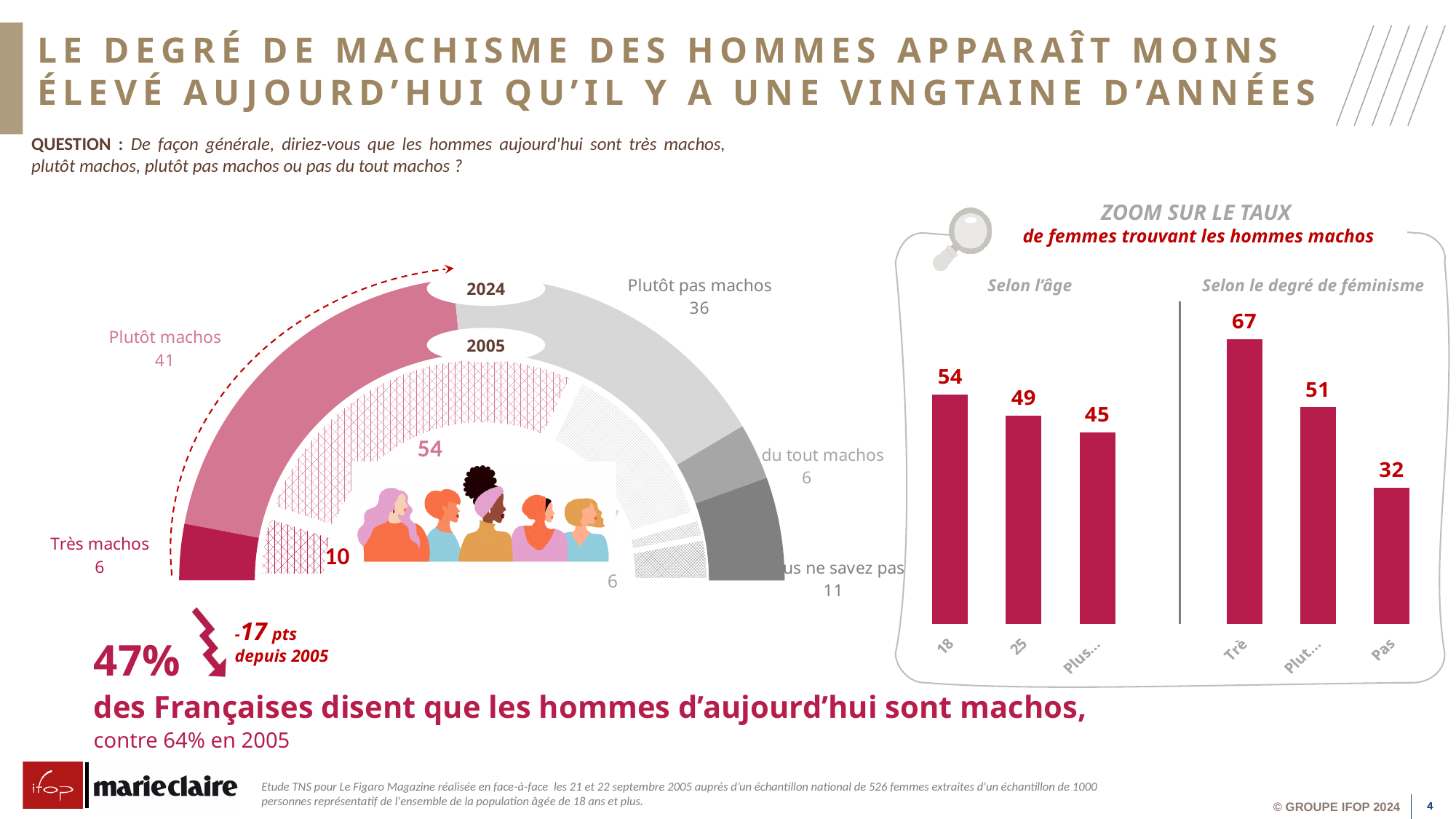
In the semi-circular chart on the left, what is the 2024 value for 'Plutôt machos'? 41 What kind of chart is the 'ZOOM SUR LE TAUX' chart on the right of the slide? bar chart In the 'ZOOM SUR LE TAUX' bar chart, what is the difference between the '18' bar and the '25' bar? 5 In the 'ZOOM SUR LE TAUX' bar chart, what is the difference between the 'Trè' bar and the 'Pas' bar? 35 In the 'ZOOM SUR LE TAUX' bar chart, how many bars are plotted in total? 6 In the 'ZOOM SUR LE TAUX' bar chart, what is the value for the 'Pas' category under 'Selon le degré de féminisme'? 32 In the 'ZOOM SUR LE TAUX' bar chart, what is the value for the '18' age category? 54 In the 'ZOOM SUR LE TAUX' bar chart, which category has the highest value? Trè In the 'ZOOM SUR LE TAUX' bar chart, which category has the lowest value? Pas In the 'ZOOM SUR LE TAUX' bar chart, which is larger: the value for '25' or the value for 'Plut...'? Plut... In the 'ZOOM SUR LE TAUX' bar chart, do the values rise or fall from '18' to 'Plus...' under 'Selon l'âge'? fall In the semi-circular chart on the left, what is the 2024 value for 'Plutôt pas machos'? 36